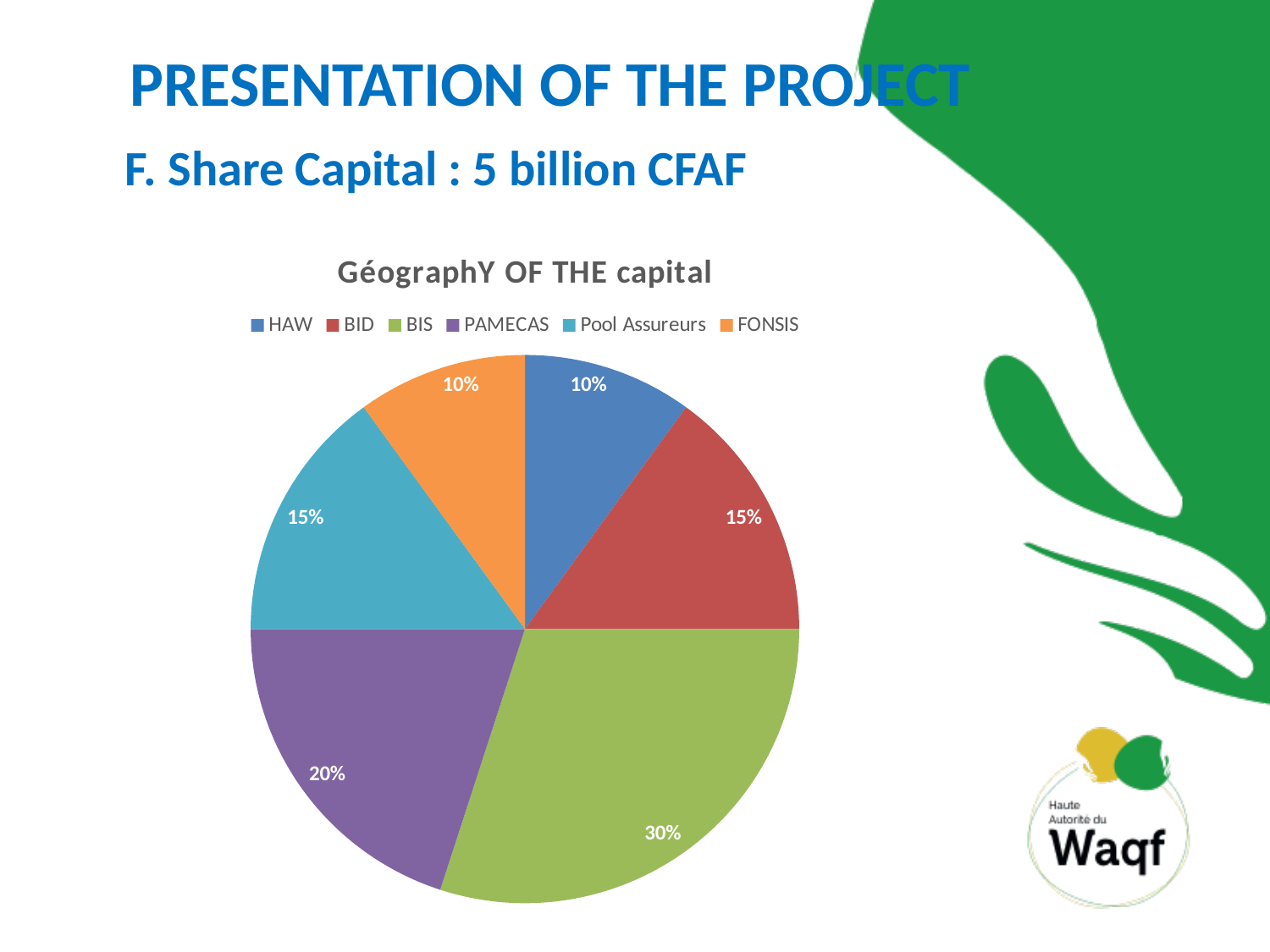
What kind of chart is shown on the slide? Pie chart What is the difference between the shares of BIS and PAMECAS? 10% What share of the capital does PAMECAS hold? 20% What share of the capital does HAW hold? 10% What share of the capital does BIS hold? 30% What colour represents FONSIS in the pie chart? Orange Which shareholder holds the largest share of the capital? BIS Which holds a larger share of the capital, BID or PAMECAS? PAMECAS How many shareholders are shown in the pie chart? 6 What is the title of the chart? GéographY OF THE capital How many entries does the legend list? 6 What share of the capital does Pool Assureurs hold? 15%